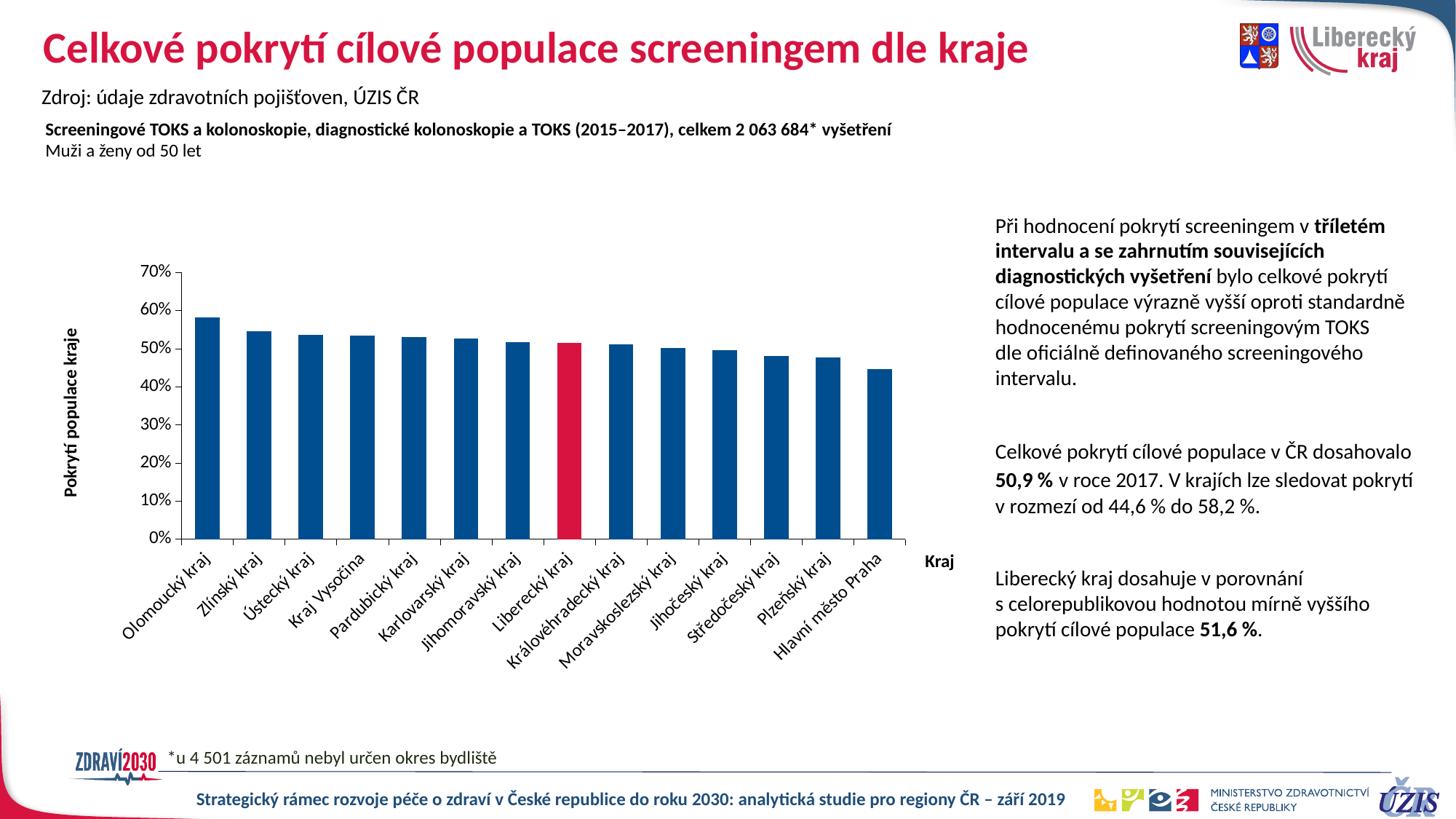
Which region (kraj) has the highest coverage in the chart? Olomoucký kraj Is the value for Zlínský kraj greater or less than 50%? greater What kind of chart is shown on the slide? bar chart Is the value for Plzeňský kraj greater or less than 50%? less How many regions are plotted in the chart? 14 Which is larger, the value for Zlínský kraj or the value for Plzeňský kraj? Zlínský kraj What is the label of the vertical axis of the chart? Pokrytí populace kraje Which region (kraj) has the lowest coverage in the chart? Hlavní město Praha Is the value for Olomoucký kraj greater or less than 50%? greater Do the values rise or fall from left to right along the x axis? fall Which region's bar is highlighted in red in the chart? Liberecký kraj